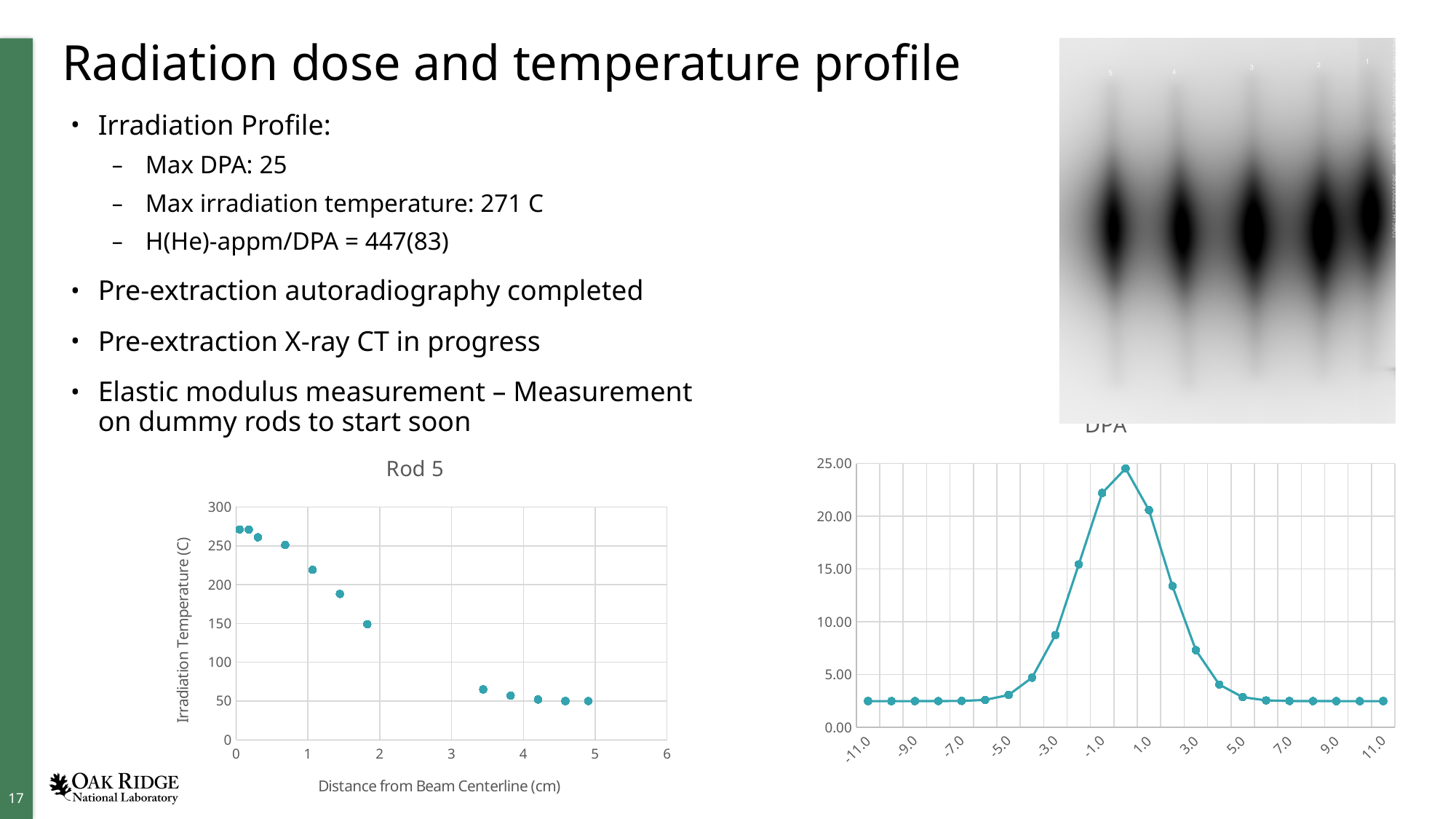
In the 'Rod 5' chart, is the irradiation temperature at a distance of about 1 cm greater or less than 200? greater In the 'DPA' chart, is the value at 11.0 greater or less than 5.00? less What kind of chart is the 'Rod 5' chart on the left? scatter chart What kind of chart is the 'DPA' chart on the right? line chart In the 'DPA' chart, is the value at -3.0 greater or less than 5.00? greater In the 'Rod 5' chart, does the irradiation temperature rise or fall as the distance from the beam centerline increases? fall What is the x-axis label of the 'Rod 5' chart? Distance from Beam Centerline (cm) What is the y-axis label of the 'Rod 5' chart? Irradiation Temperature (C)